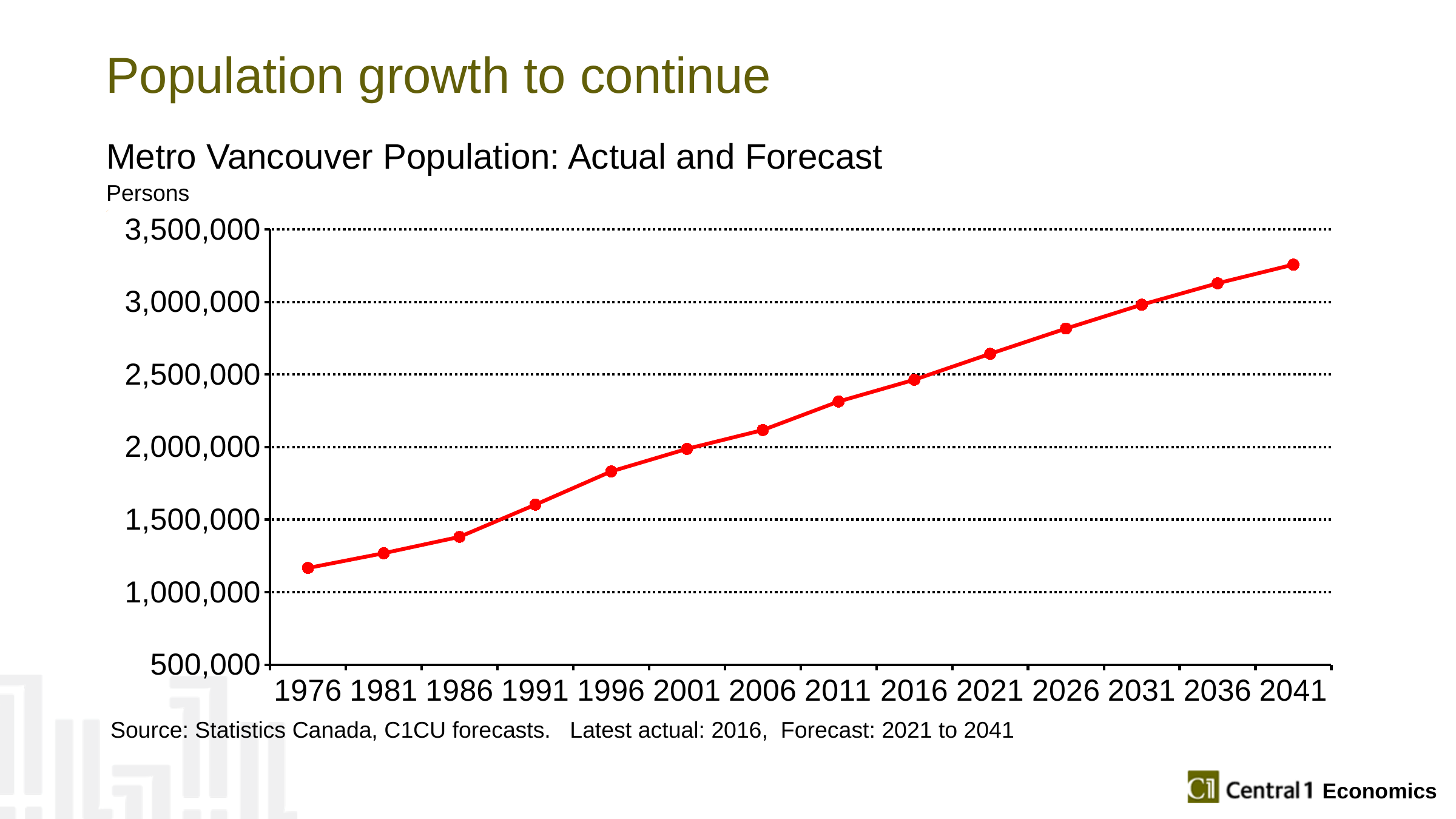
Which is larger, the value for 2011 or the value for 1996? 2011 Which year has the lowest population value on the chart? 1976 Is the value for 2006 greater or less than 2,000,000? greater Is the value for 2021 greater or less than 2,500,000? greater Is the value for 1991 greater or less than 1,500,000? greater Which year has the highest population value on the chart? 2041 Do the population values rise or fall from 1976 to 2041? rise What is the title of the chart? Metro Vancouver Population: Actual and Forecast What kind of chart is shown on the slide? line chart How many data points are plotted on the chart? 14